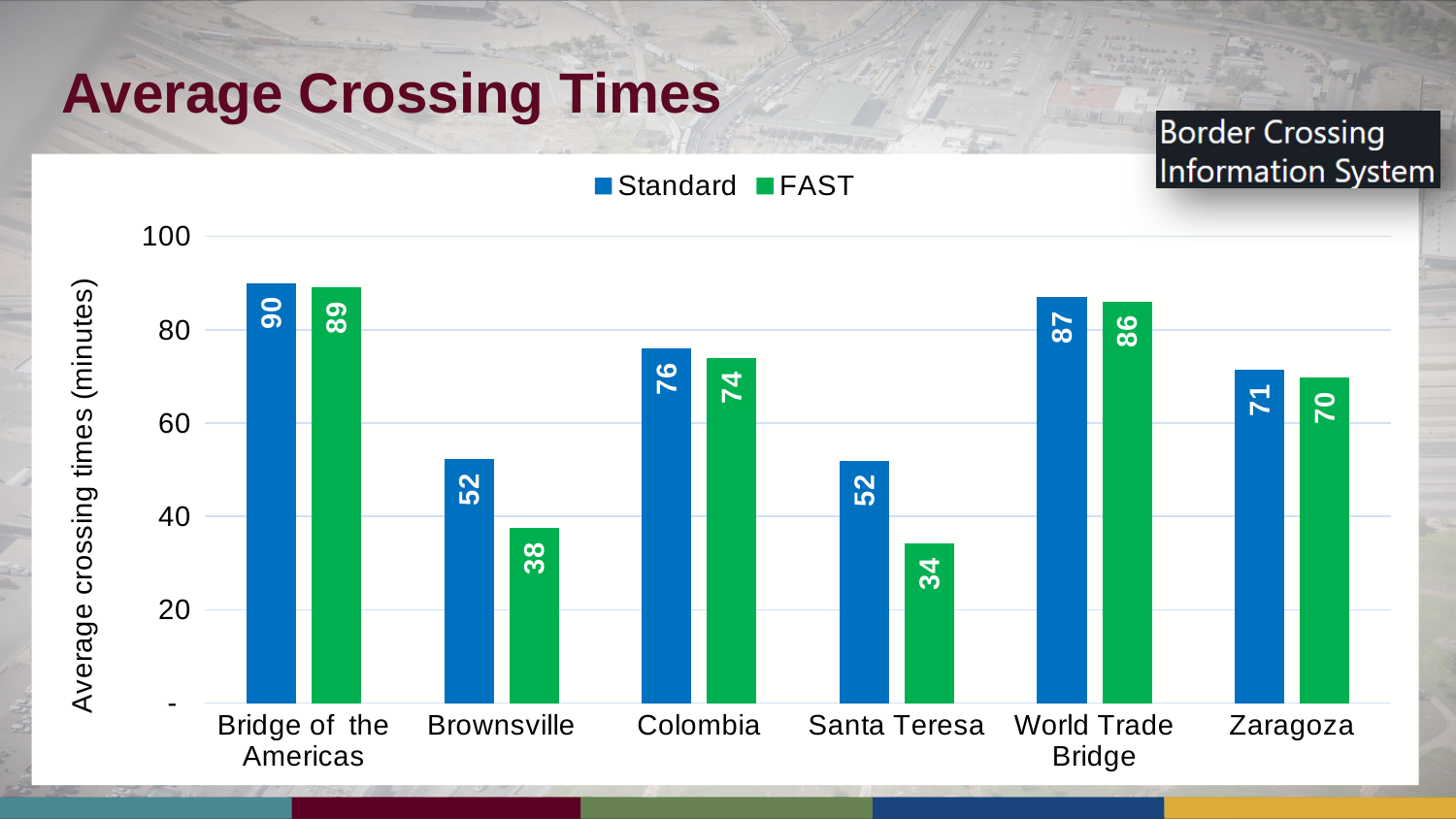
Which crossing has the highest Standard average crossing time? Bridge of the Americas What kind of chart is shown on the slide? Bar chart Which crossing has the lowest FAST average crossing time? Santa Teresa What is the difference between the Standard and FAST crossing times at Brownsville? 14 Which is larger, the FAST crossing time at Colombia or the FAST crossing time at Zaragoza? Colombia What is the FAST average crossing time for Santa Teresa? 34 What is the Standard average crossing time for Brownsville? 52 How many crossings are shown on the x axis? 6 What is the title of the chart? Average Crossing Times What is the FAST average crossing time for World Trade Bridge? 86 What is the difference between the Standard crossing times at Colombia and Zaragoza? 5 How many series does the legend list? 2